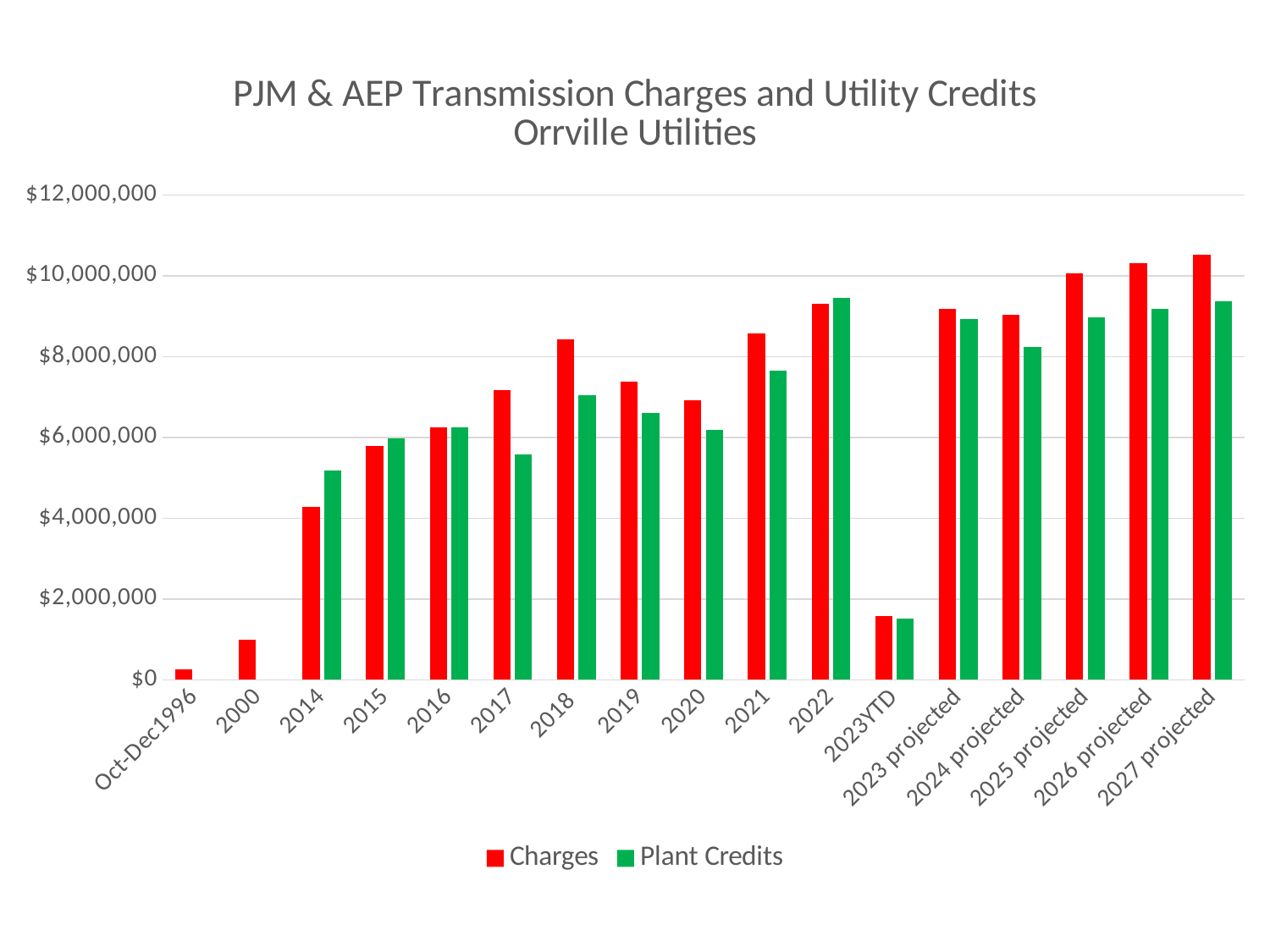
Which category has the lowest Charges value? Oct-Dec1996 Is the Charges value for 2026 projected greater or less than $10,000,000? greater For 2014, which is larger: Charges or Plant Credits? Plant Credits Is the Plant Credits value for 2017 greater or less than $6,000,000? less How many categories are shown on the x axis? 17 Which category has the highest Charges value? 2027 projected How many series does the legend list? 2 For 2021, which is larger: Charges or Plant Credits? Charges What kind of chart is shown on the slide? bar chart Is the Charges value for 2023YTD greater or less than $2,000,000? less Do the Charges values rise or fall from 2014 to 2018? rise